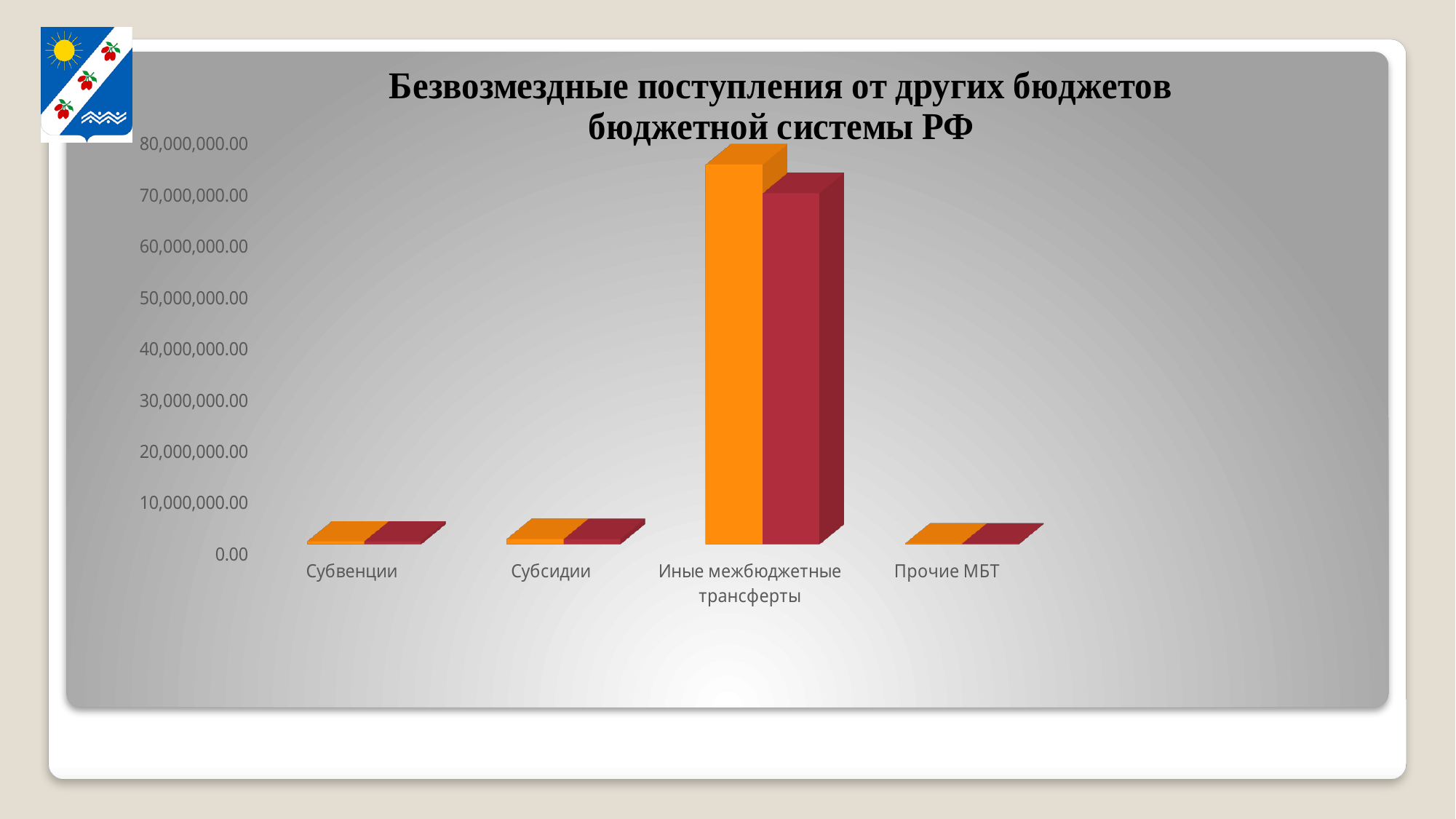
What kind of chart is shown on the slide? bar chart Is the red bar for Прочие МБТ greater or less than 10,000,000.00? less How many bars are plotted for each category in the chart? 2 For Иные межбюджетные трансферты, which bar is taller, the orange one or the red one? the orange one What is the title of the chart? Безвозмездные поступления от других бюджетов бюджетной системы РФ How many categories are shown on the x axis of the chart? 4 Is the orange bar for Субвенции greater or less than 10,000,000.00? less What is the highest value labelled on the vertical axis of the chart? 80,000,000.00 Is the red bar for Иные межбюджетные трансферты greater or less than 60,000,000.00? greater Which is larger: the orange bar for Иные межбюджетные трансферты or the orange bar for Субсидии? Иные межбюджетные трансферты Which category has the highest values in the chart? Иные межбюджетные трансферты